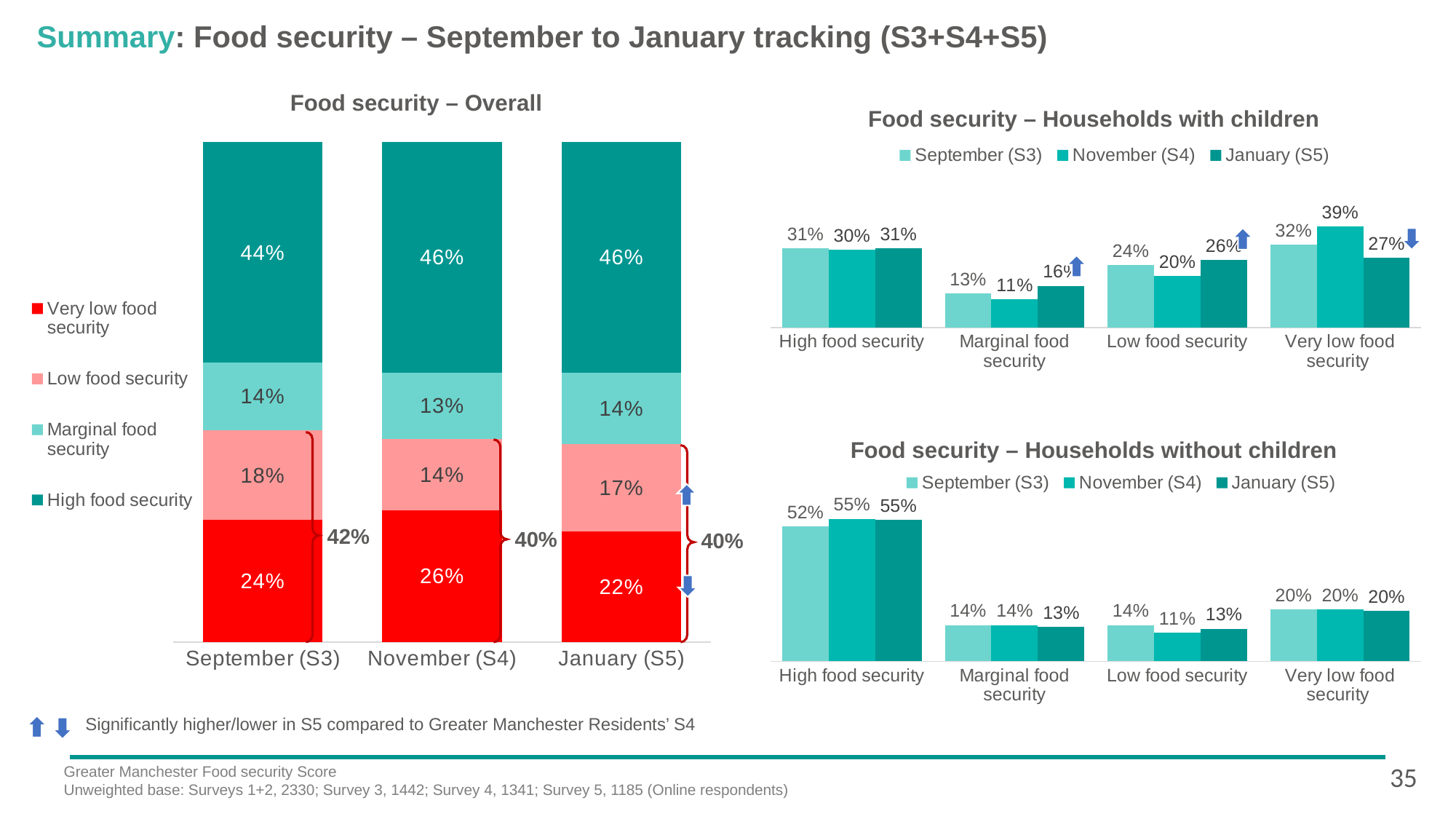
In the 'Food security – Households without children' chart, how many categories are shown on the x axis? 4 In the 'Food security – Overall' chart, what is the value for High food security in September (S3)? 44% In the 'Food security – Households with children' chart, is the value for Low food security in January (S5) larger than in November (S4)? Yes In the 'Food security – Households with children' chart, what is the value for Very low food security in November (S4)? 39% In the 'Food security – Households without children' chart, which category has the highest values across all three surveys? High food security In the 'Food security – Overall' chart, what is the difference between Low food security in September (S3) and in November (S4)? 4% In the 'Food security – Households with children' chart, which survey has the lowest value for Marginal food security? November (S4) In the 'Food security – Overall' chart, how many series does the legend list? 4 In the 'Food security – Households without children' chart, what is the difference between High food security in November (S4) and September (S3)? 3% In the 'Food security – Overall' chart, what is the value for Very low food security in November (S4)? 26% What kind of chart is 'Food security – Overall'? Stacked bar chart In the 'Food security – Households without children' chart, what is the value for High food security in September (S3)? 52%